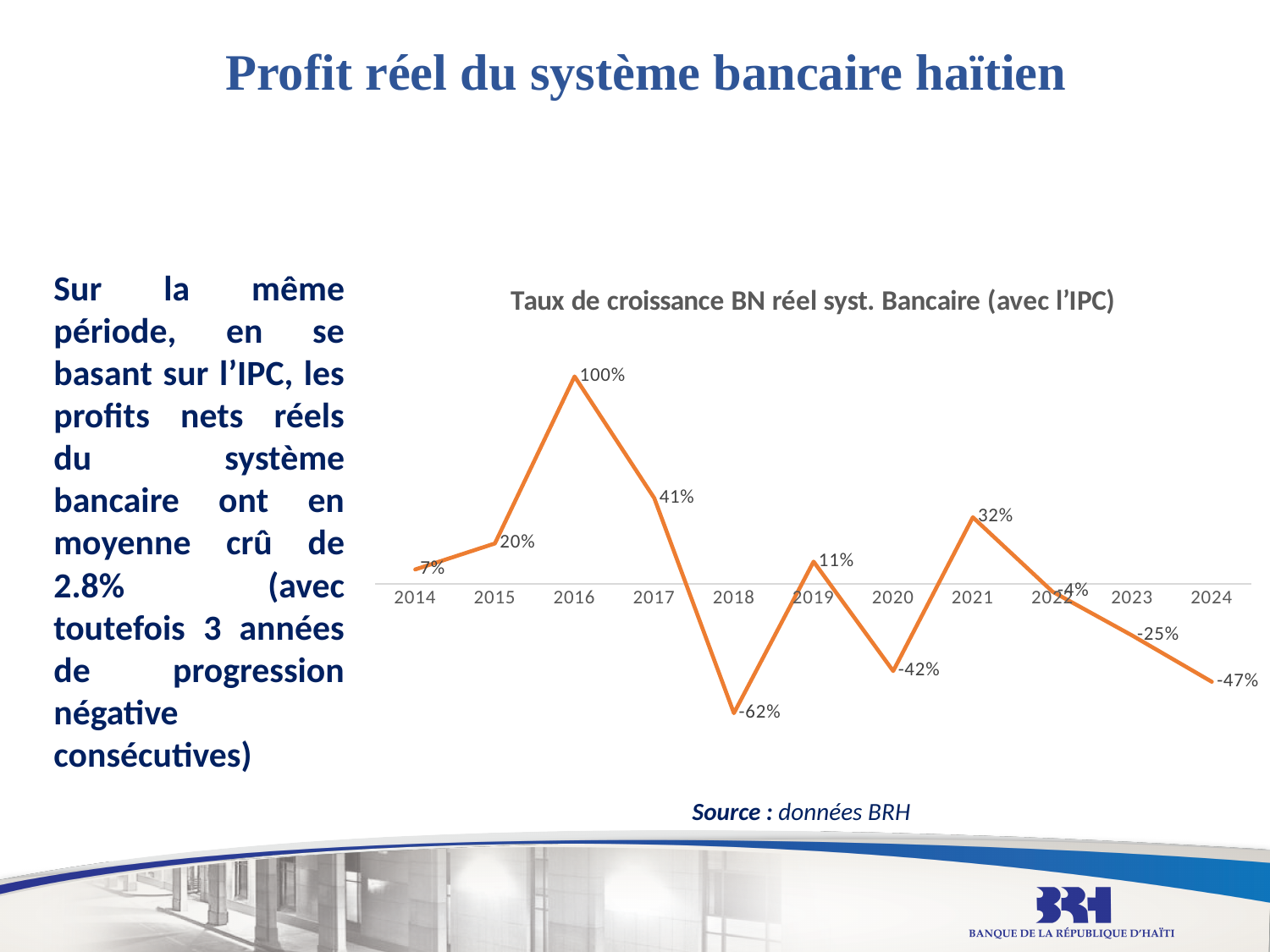
What is the value for 2016 in the chart? 100% What is the difference between the values for 2016 and 2017? 59 percentage points Which year has the larger value, 2017 or 2021? 2017 What kind of chart is shown on the slide? Line chart How many years are plotted on the x axis of the chart? 11 Do the values rise or fall from 2021 to 2024? Fall What is the value for 2020 in the chart? -42% What is the value for 2021 in the chart? 32% What is the value for 2018 in the chart? -62% What is the value for 2024 in the chart? -47% Which year has the highest value in the chart? 2016 Which year has the lowest value in the chart? 2018